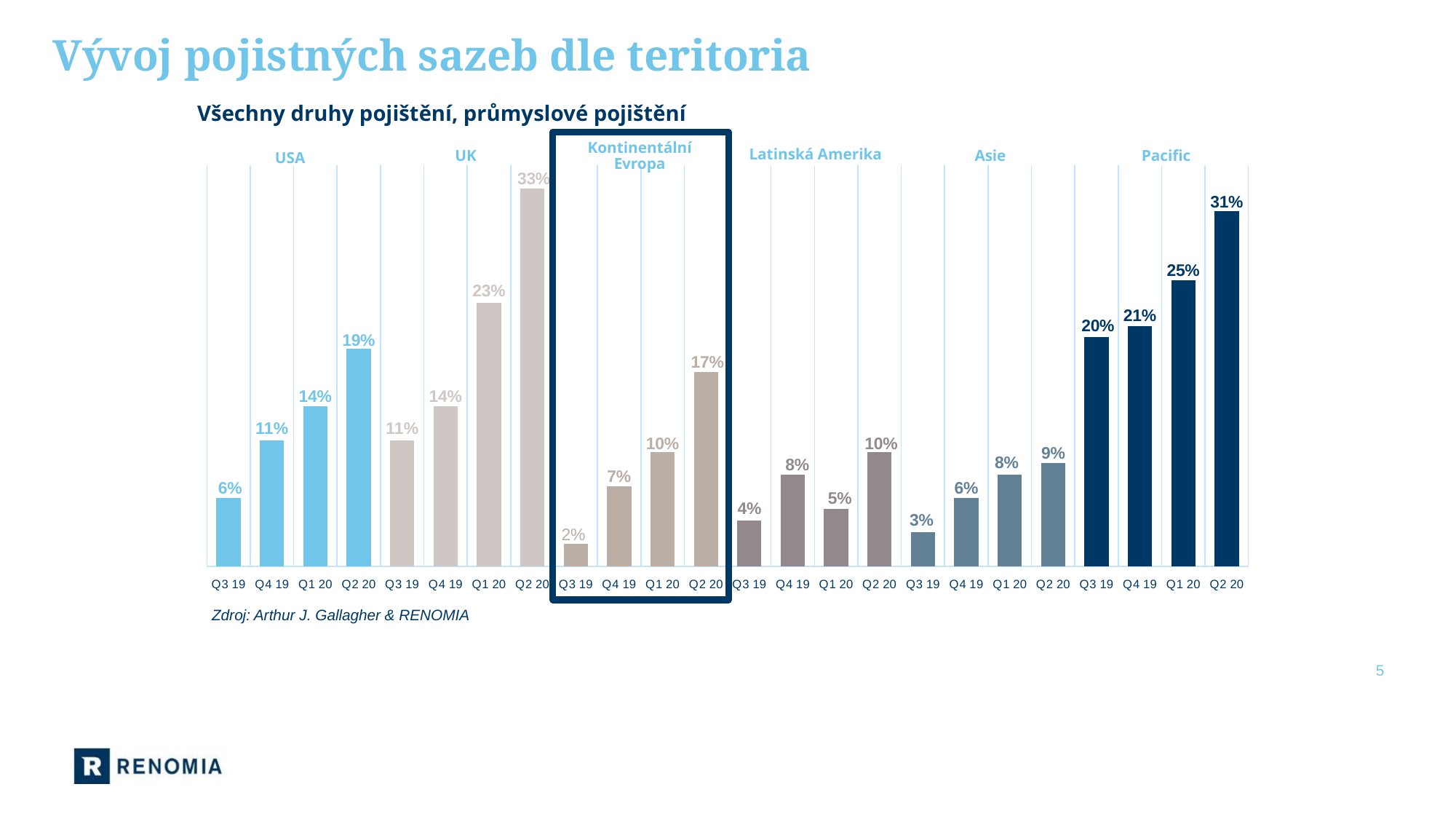
How many bars are shown in the Asie group? 4 What is the value for Q4 19 in the Latinská Amerika group? 8% What type of chart is shown on the slide? Bar chart Which bar has the lowest value on the chart? Kontinentální Evropa Q3 19 What is the difference between the Q2 20 and Q3 19 values in the USA group? 13% Which region has the highest bar on the chart? UK (Q2 20) What is the value for Q3 19 in the Kontinentální Evropa group? 2% Which is larger: the Q2 20 value for Pacific or the Q2 20 value for UK? UK How many regions are shown on the chart? 6 What is the value for Q1 20 in the Pacific group? 25% What is the value for Q2 20 in the UK group? 33% Do the values in the Pacific group rise or fall from Q3 19 to Q2 20? Rise